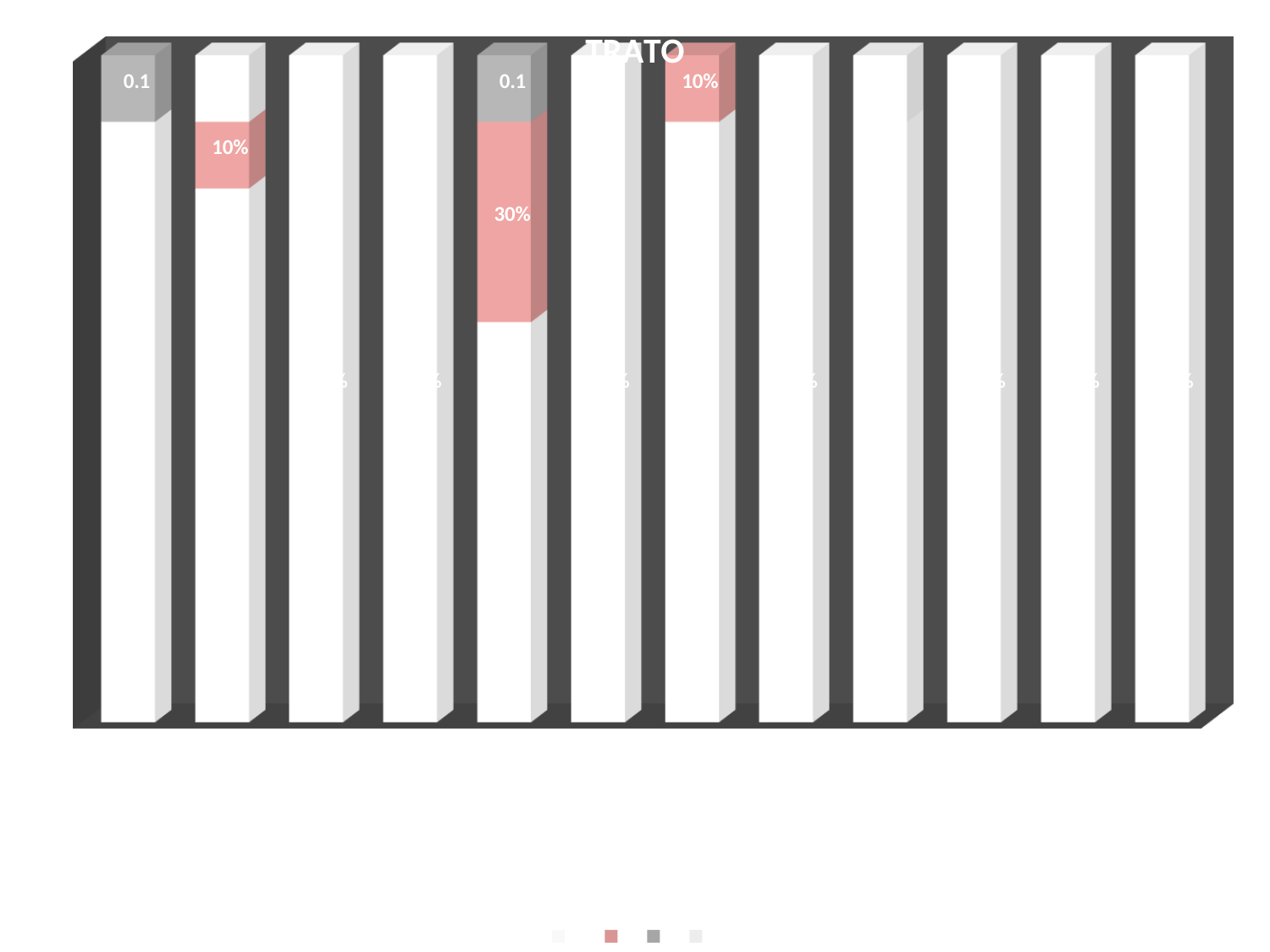
What kind of chart is shown on the slide? Stacked bar chart What value is labelled on the pink segment of the second bar from the left? 10% How many bars are plotted in the chart? 12 What is the difference between the pink segment of the fifth bar from the left and the pink segment of the seventh bar from the left? 20% Is the pink segment of the fifth bar from the left larger or smaller than the pink segment of the second bar from the left? Larger What value is labelled on the pink segment of the seventh bar from the left? 10% What value is labelled on the grey segment of the first bar from the left? 0.1 Which bar has the largest pink segment? The fifth bar from the left What value is labelled on the pink segment of the fifth bar from the left? 30% What is the title of the chart? TRATO How many series does the legend list? 4 What value is labelled on the grey segment of the fifth bar from the left? 0.1